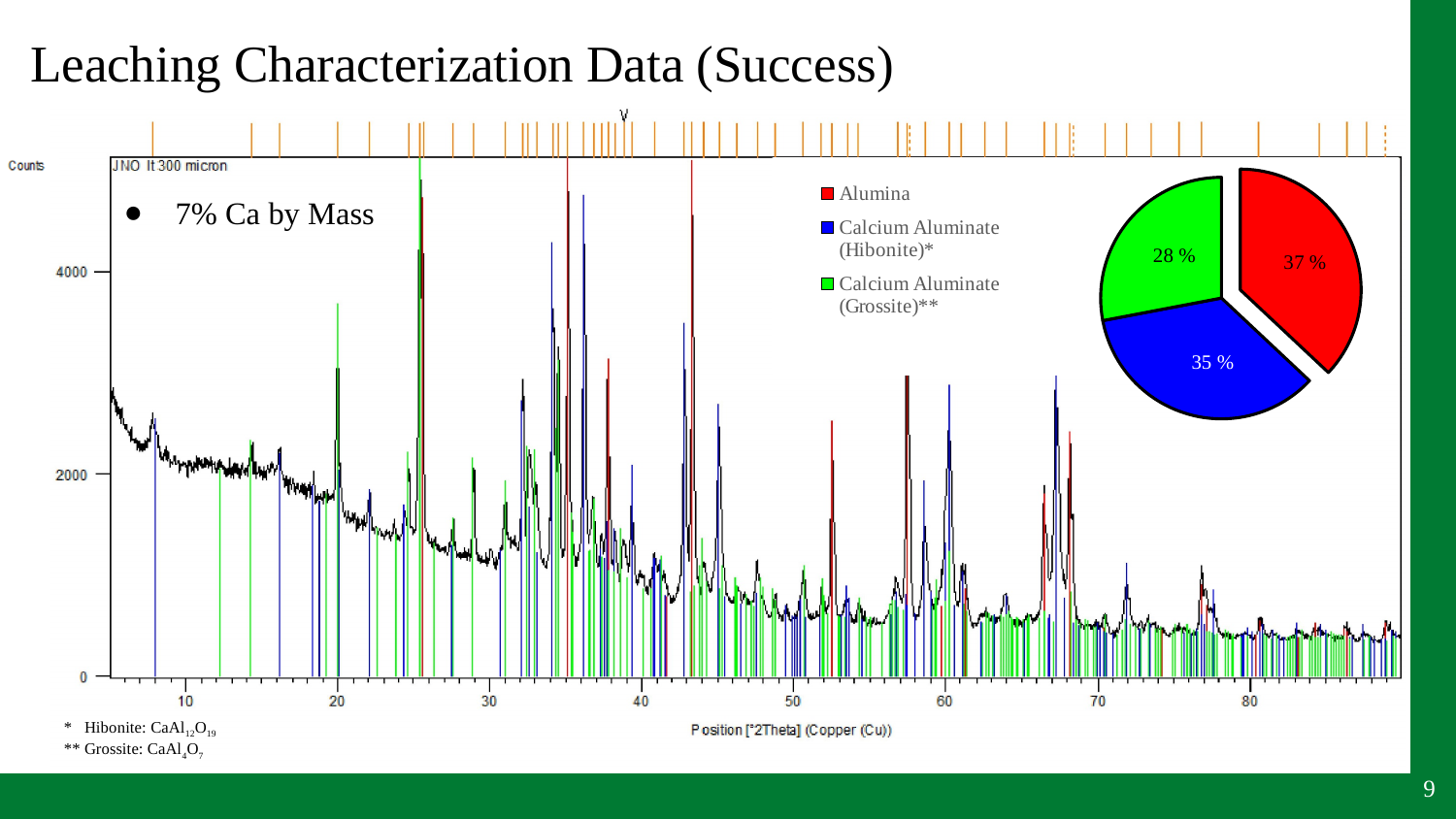
In the pie chart, what is the difference in percentage points between Calcium Aluminate (Hibonite) and Calcium Aluminate (Grossite)? 7 In the pie chart, which phase has the largest share? Alumina In the pie chart, what is the difference in percentage points between Alumina and Calcium Aluminate (Grossite)? 9 In the pie chart, which is larger: the share for Alumina or the share for Calcium Aluminate (Hibonite)? Alumina What kind of chart is the chart in the upper right of the slide? Pie chart How many slices does the pie chart have? 3 In the pie chart, what share is shown for Calcium Aluminate (Hibonite)? 35 % In the pie chart, what colour is the Calcium Aluminate (Hibonite) slice? Blue How many entries does the pie chart legend list? 3 In the pie chart, what share is shown for Calcium Aluminate (Grossite)? 28 % In the pie chart, what share is shown for Alumina? 37 % In the pie chart, which phase has the smallest share? Calcium Aluminate (Grossite)